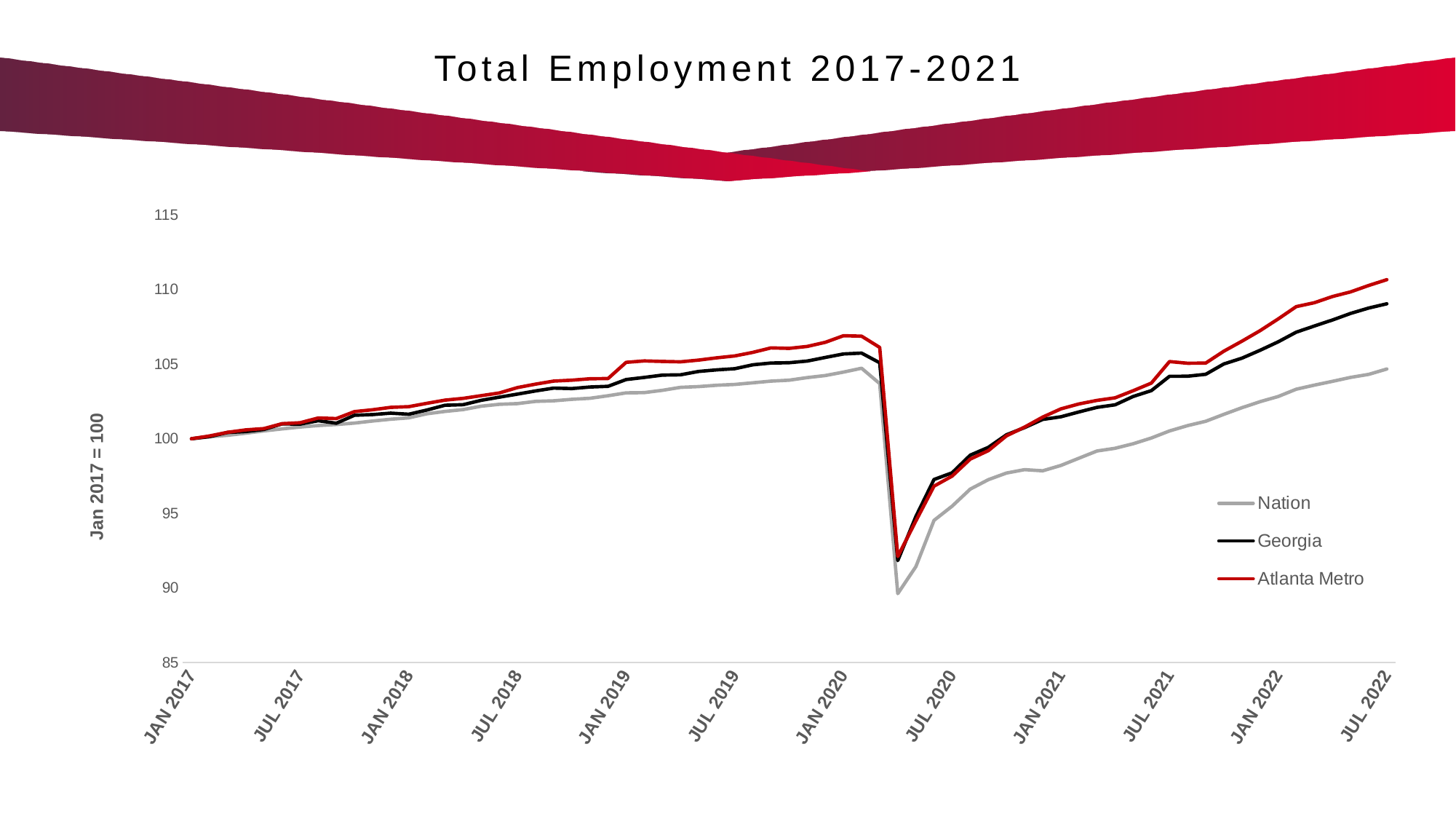
What is the index value for all three series at JAN 2017? 100 Is the value for Georgia at JUL 2022 greater or less than 110? less Which series falls to the lowest value during the 2020 drop? Nation Do the values for Nation rise or fall from JAN 2017 to JAN 2020? rise How many series does the legend list? 3 Which series has the highest value at JUL 2022? Atlanta Metro Is the value for Atlanta Metro at JUL 2022 greater or less than 110? greater What is the title of the chart? Total Employment 2017-2021 At JUL 2022, which is larger: the value for Atlanta Metro or the value for Nation? Atlanta Metro What is the label on the vertical axis? Jan 2017 = 100 Is the lowest value for Georgia in 2020 greater or less than 90? greater What kind of chart is shown on the slide? line chart